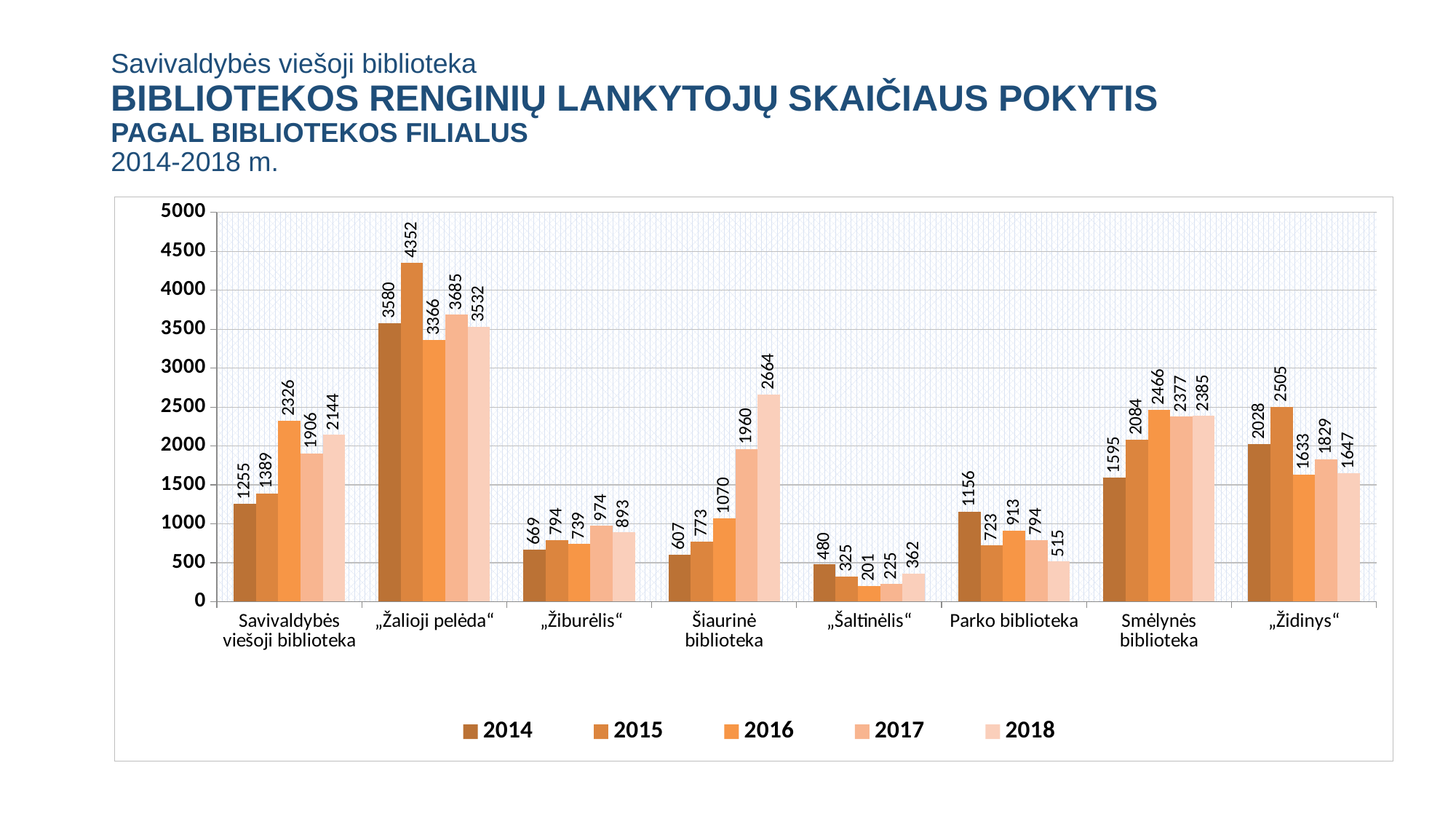
What is the value for Parko biblioteka in 2014? 1156 How many series does the legend list? 5 Which is larger for „Židinys“: the 2014 value or the 2017 value? 2014 What is the difference between the 2018 and 2014 values for Šiaurinė biblioteka? 2057 What years does the legend list? 2014, 2015, 2016, 2017, 2018 What is the value for „Žalioji pelėda“ in 2015? 4352 How many library branches are shown on the x axis? 8 Which branch has the highest value in 2016? „Žalioji pelėda“ Do the values for „Šaltinėlis“ rise or fall from 2014 to 2016? fall What is the value for Šiaurinė biblioteka in 2018? 2664 Which branch has the lowest value in 2017? „Šaltinėlis“ What kind of chart is shown on the slide? bar chart